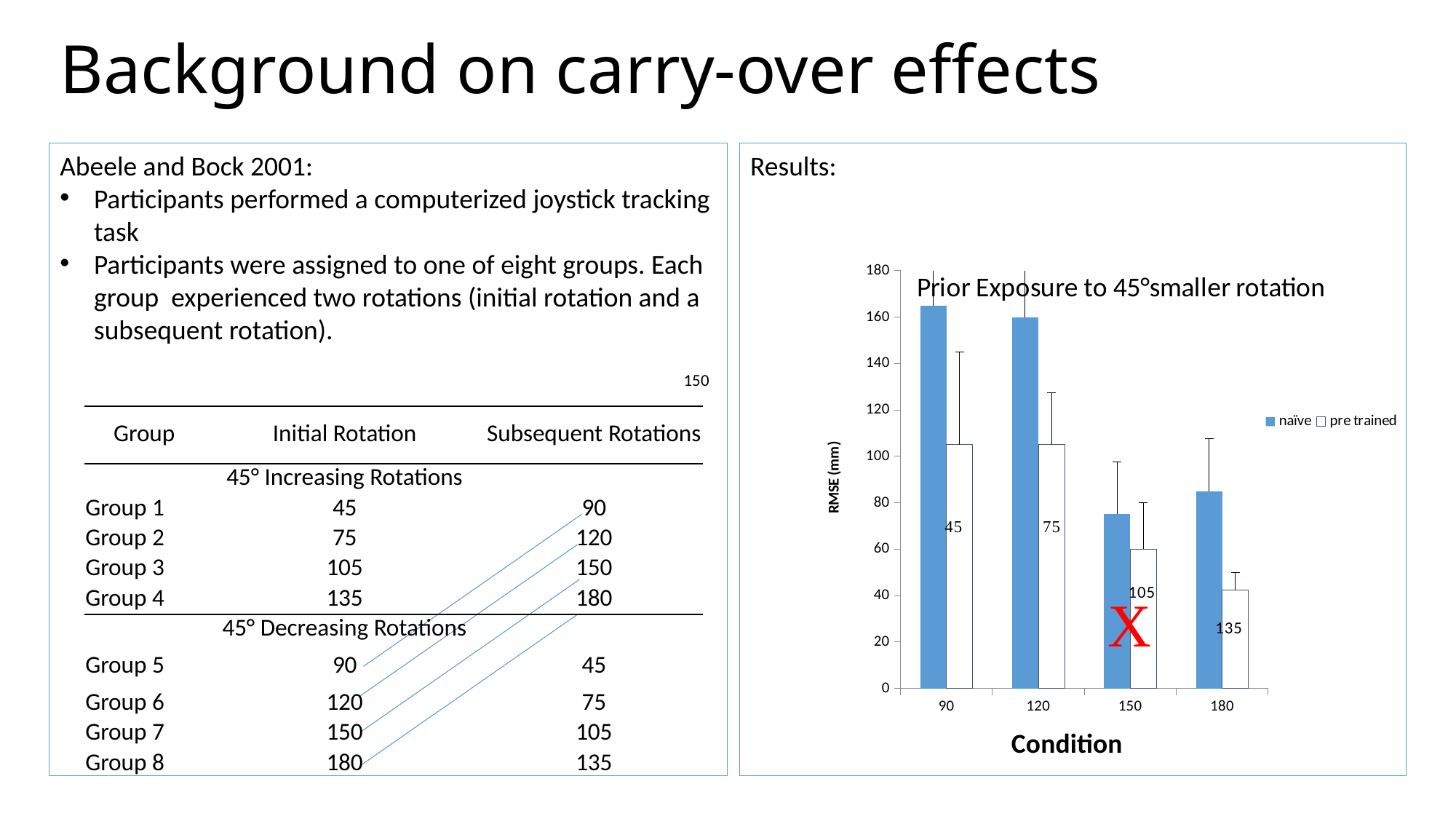
How many series does the legend of the Results chart list? 2 What kind of chart is shown in the Results panel? bar chart In the Results chart, is the naïve value for condition 90 greater or less than 140? greater What is the x-axis title of the Results chart? Condition How many conditions are shown along the x axis of the Results chart? 4 In the Results chart, is the naïve value for condition 150 greater or less than 100? less In the Results chart, at condition 150, is the naïve bar or the pre trained bar taller? naïve In the Results chart, which condition has the lowest naïve RMSE? 150 In the Results chart, at condition 90, which series has the larger RMSE: naïve or pre trained? naïve In the Results chart, which condition has the lowest pre trained RMSE? 180 What is the y-axis title of the Results chart? RMSE (mm) In the Results chart, is the pre trained value for condition 180 greater or less than 60? less